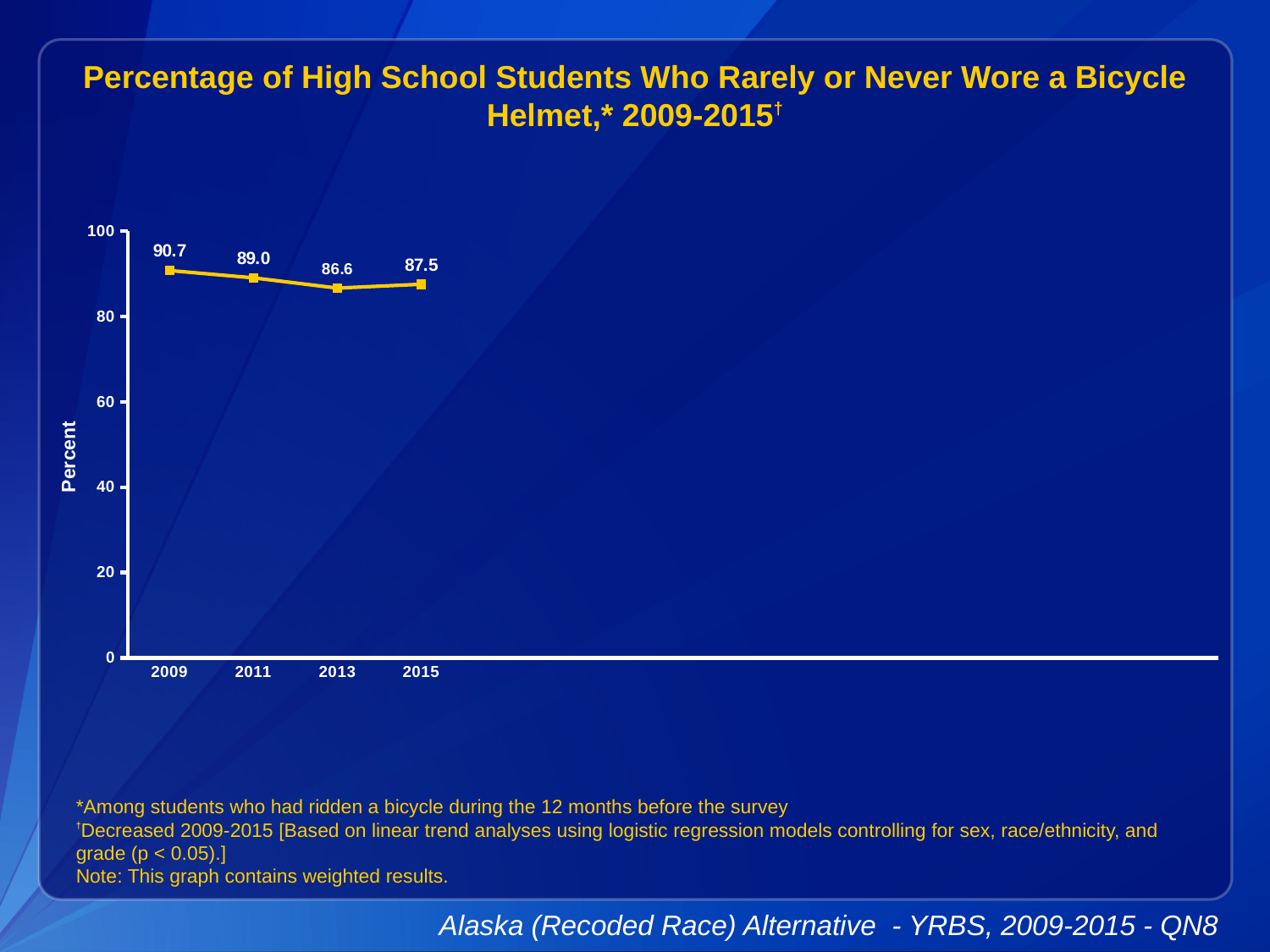
Is the value for 2013 greater or less than 80? greater What value is shown for 2015? 87.5 Which year has the lowest percentage? 2013 Does the percentage rise or fall from 2009 to 2013? fall What is the label on the y axis? Percent What was the percentage of high school students who rarely or never wore a bicycle helmet in 2009? 90.7 What value is shown for 2013? 86.6 What is the difference between the 2009 value and the 2015 value? 3.2 How many years are plotted on the chart? 4 What kind of chart is shown on the slide? line chart Which year has the highest percentage? 2009 Which is larger, the value for 2011 or the value for 2015? 2011